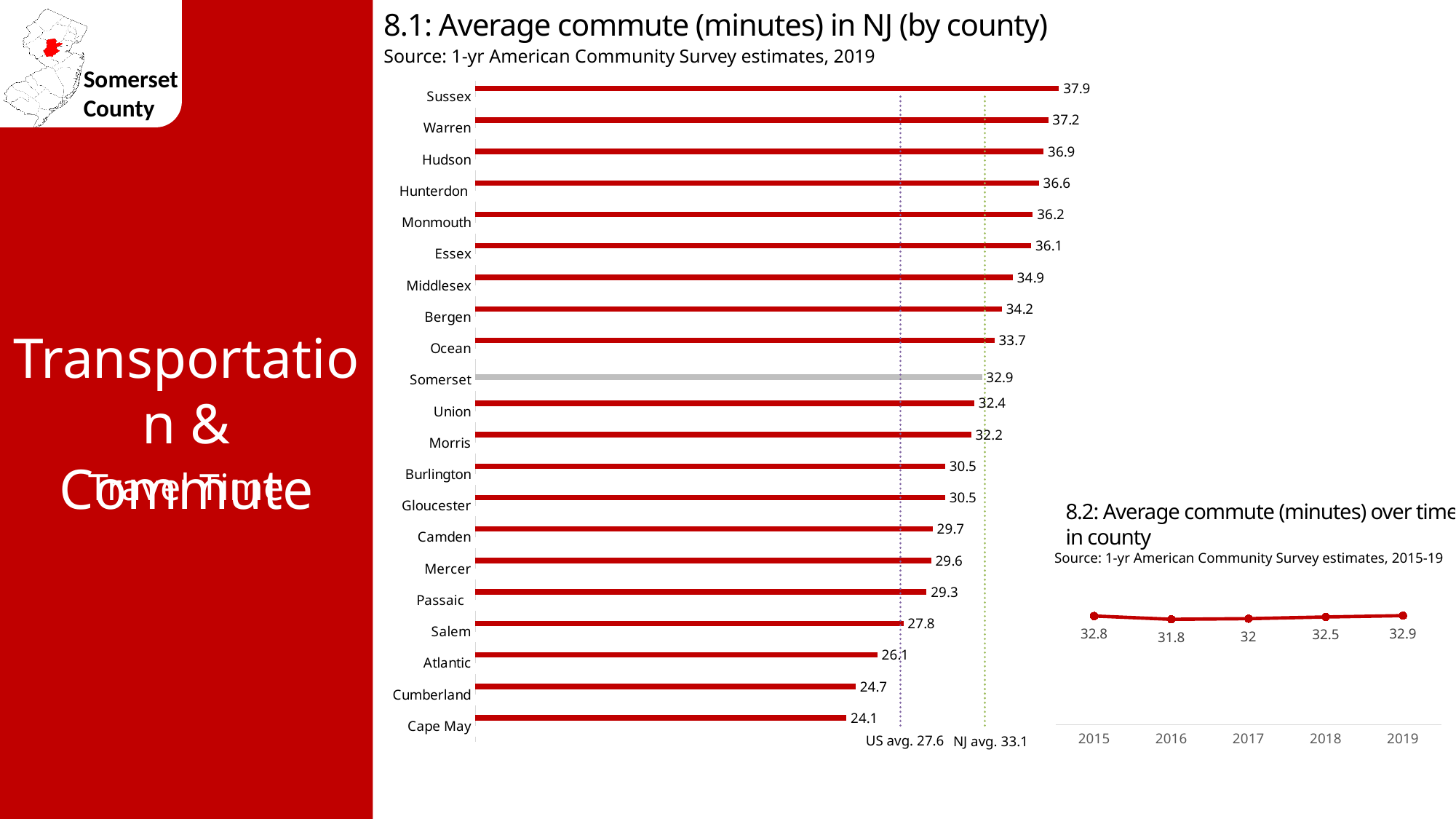
In chart 8.1, which county has the lowest average commute? Cape May In chart 8.1, which county has the highest average commute? Sussex In chart 8.2, how many years are plotted? 5 In chart 8.2, which year had the lowest average commute? 2016 What kind of chart is chart 8.1? Bar chart In chart 8.2, what was the average commute in 2016? 31.8 In chart 8.1, which has a longer average commute, Hudson or Bergen? Hudson In chart 8.1, what is the difference between the average commute for Sussex and Cape May? 13.8 In chart 8.1, what is the average commute in minutes for Somerset? 32.9 In chart 8.1, what is the NJ average commute shown by the dotted reference line? 33.1 In chart 8.1, how many counties are shown? 21 In chart 8.2, what is the difference between the 2019 and 2016 values? 1.1